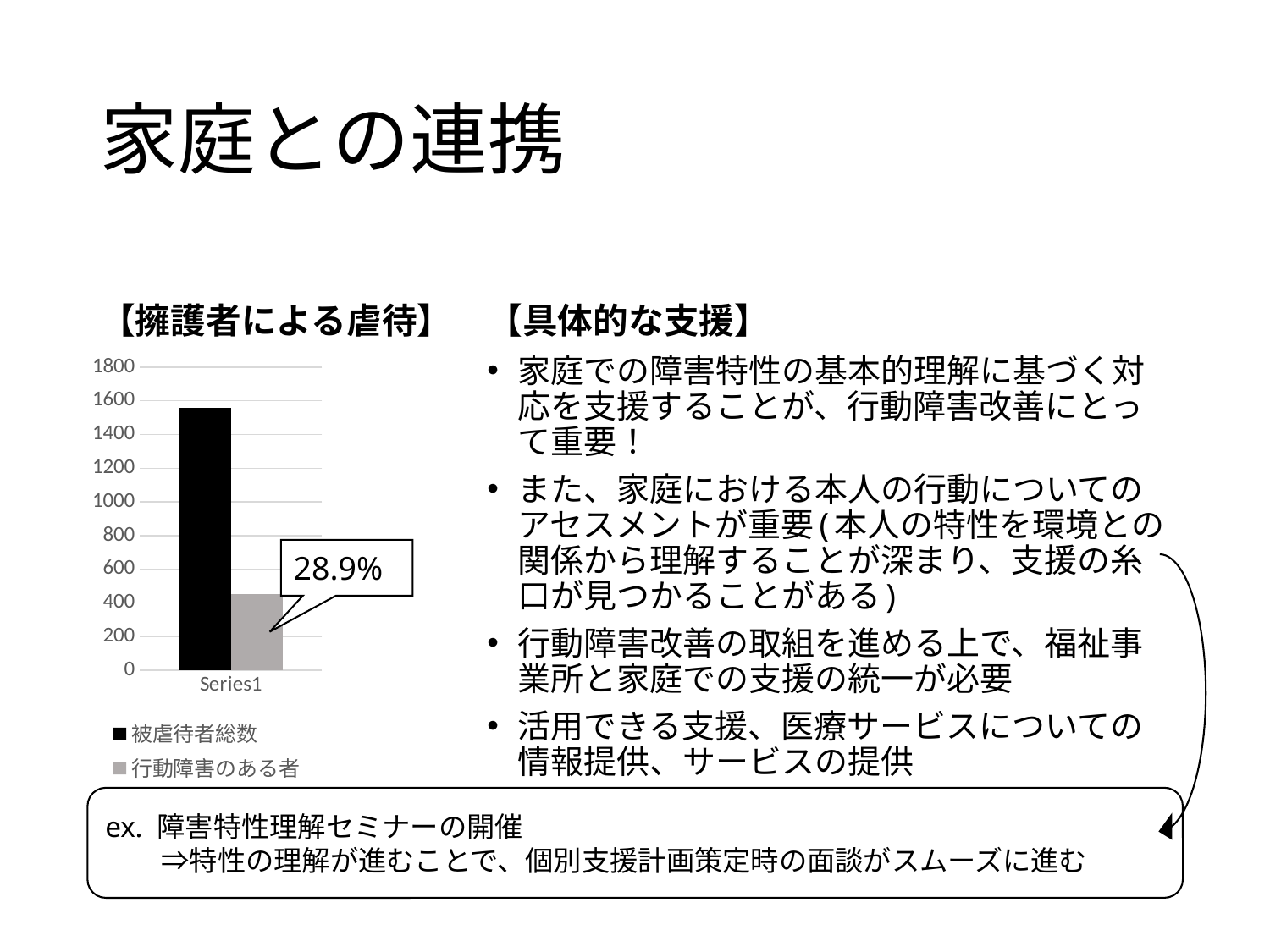
What kind of chart is shown under the heading 【擁護者による虐待】? bar chart What percentage is shown in the callout pointing to the 行動障害のある者 bar? 28.9% Which series has the highest bar in the chart? 被虐待者総数 Which series has the lowest bar in the chart? 行動障害のある者 Which series has the taller bar in the chart, 被虐待者総数 or 行動障害のある者? 被虐待者総数 What is the label of the category on the x axis of the chart? Series1 How many categories are shown on the x axis of the chart? 1 How many series does the legend of the chart list? 2 Is the value for 被虐待者総数 greater or less than 1400? greater Is the value for 行動障害のある者 greater or less than 600? less